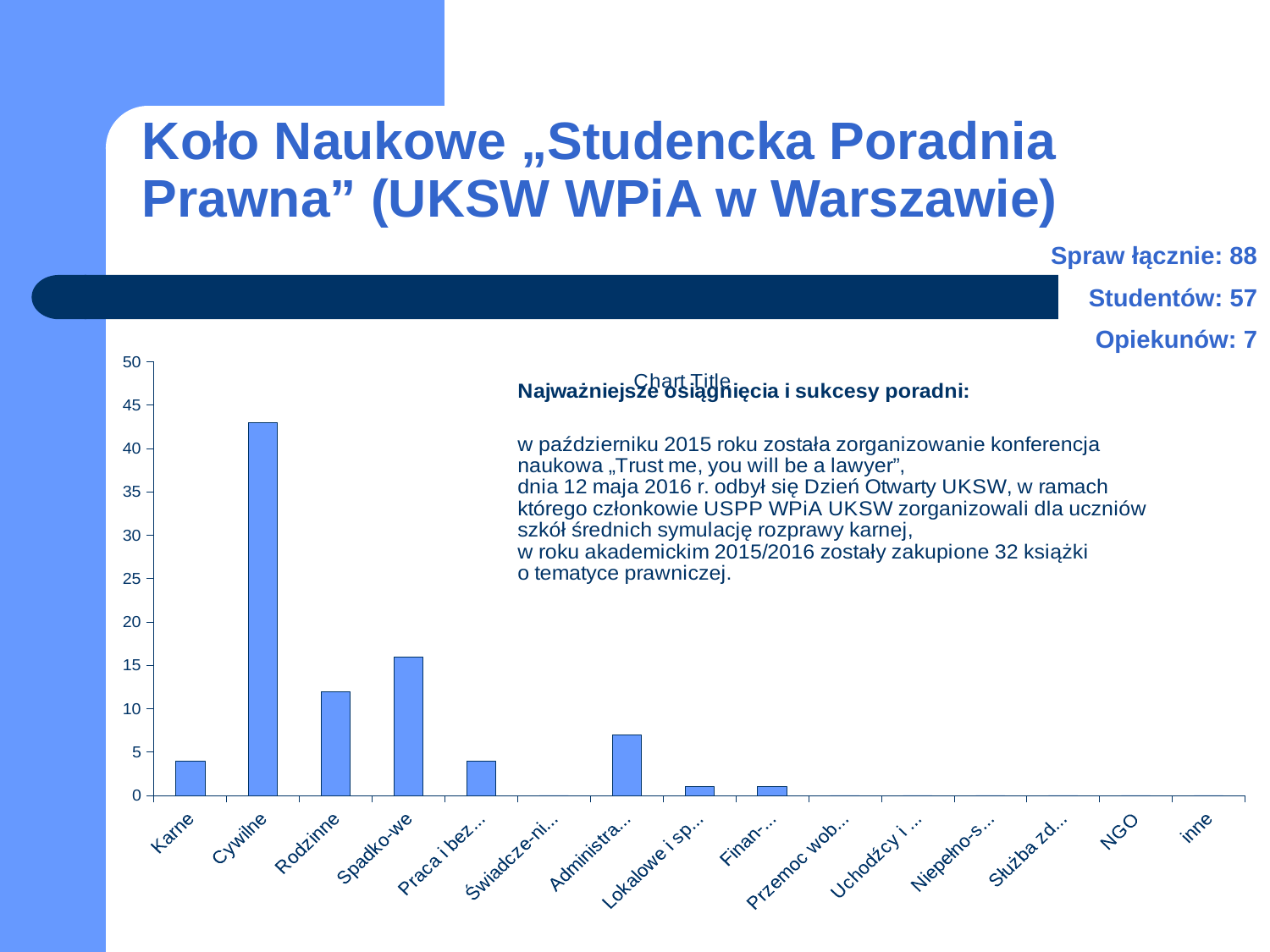
Is the value for Rodzinne greater or less than 10? greater Is the value for Administra... greater or less than 5? greater What title is displayed on the chart? Chart Title Which is larger, the value for Cywilne or the value for Spadko-we? Cywilne Is the value for Spadko-we greater or less than 10? greater What kind of chart is shown on the slide? bar chart Which category has the highest bar in the chart? Cywilne How many categories are shown on the x axis of the chart? 15 Which is larger, the value for Spadko-we or the value for Rodzinne? Spadko-we